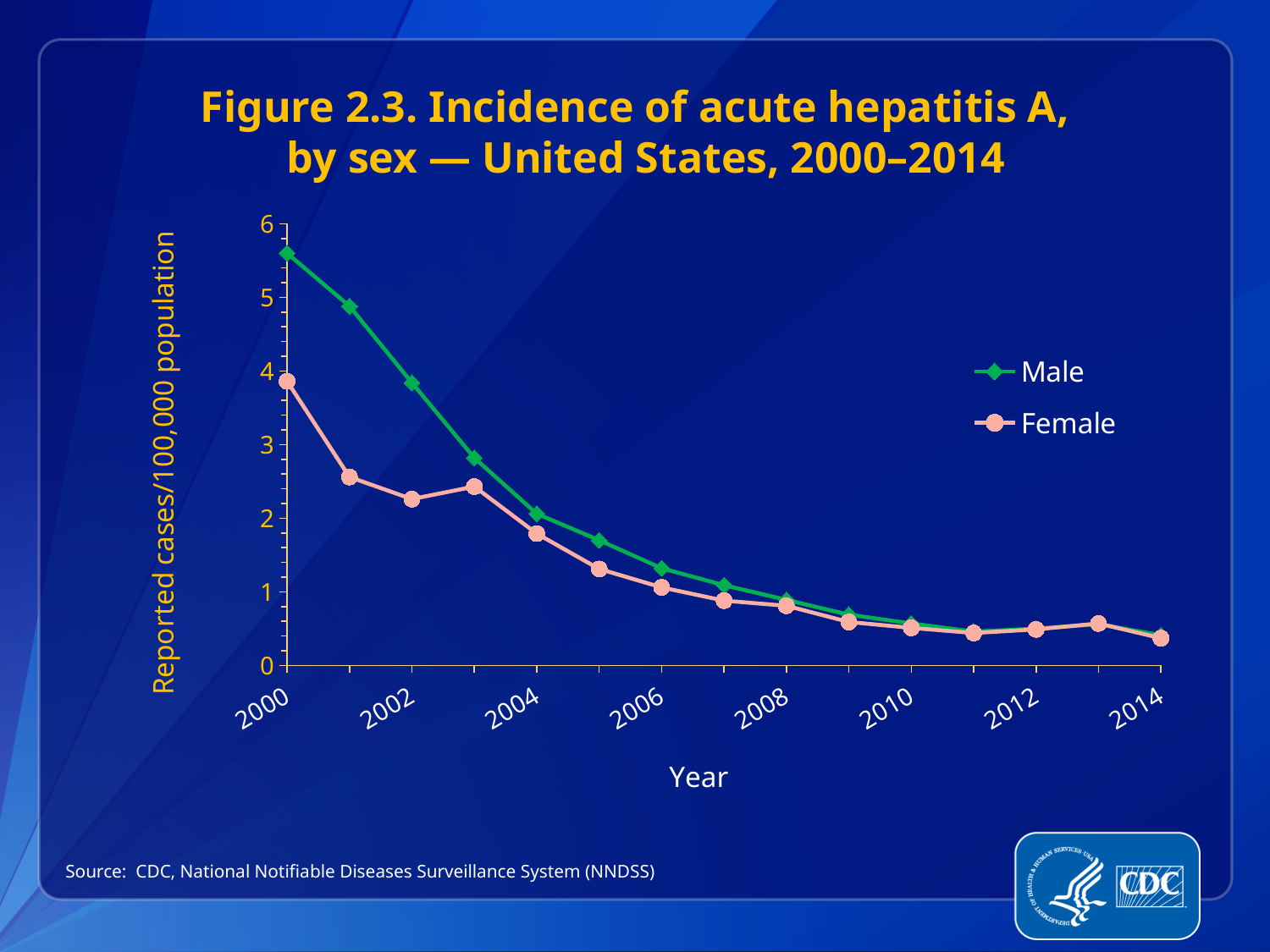
In which year is the Male incidence rate highest? 2000 Is the Female value for 2000 greater or less than 4? less What kind of chart is shown on the slide? line chart Does the Male incidence rate generally rise or fall from 2000 to 2014? fall Is the Female value for 2001 greater or less than 2? greater What is the label of the y axis? Reported cases/100,000 population Is the Male value for 2000 greater or less than 5? greater In 2000, which series has the higher incidence, Male or Female? Male How many years are plotted along the x axis, from 2000 to 2014? 15 Which two series are shown in the legend? Male and Female How many series does the legend list? 2